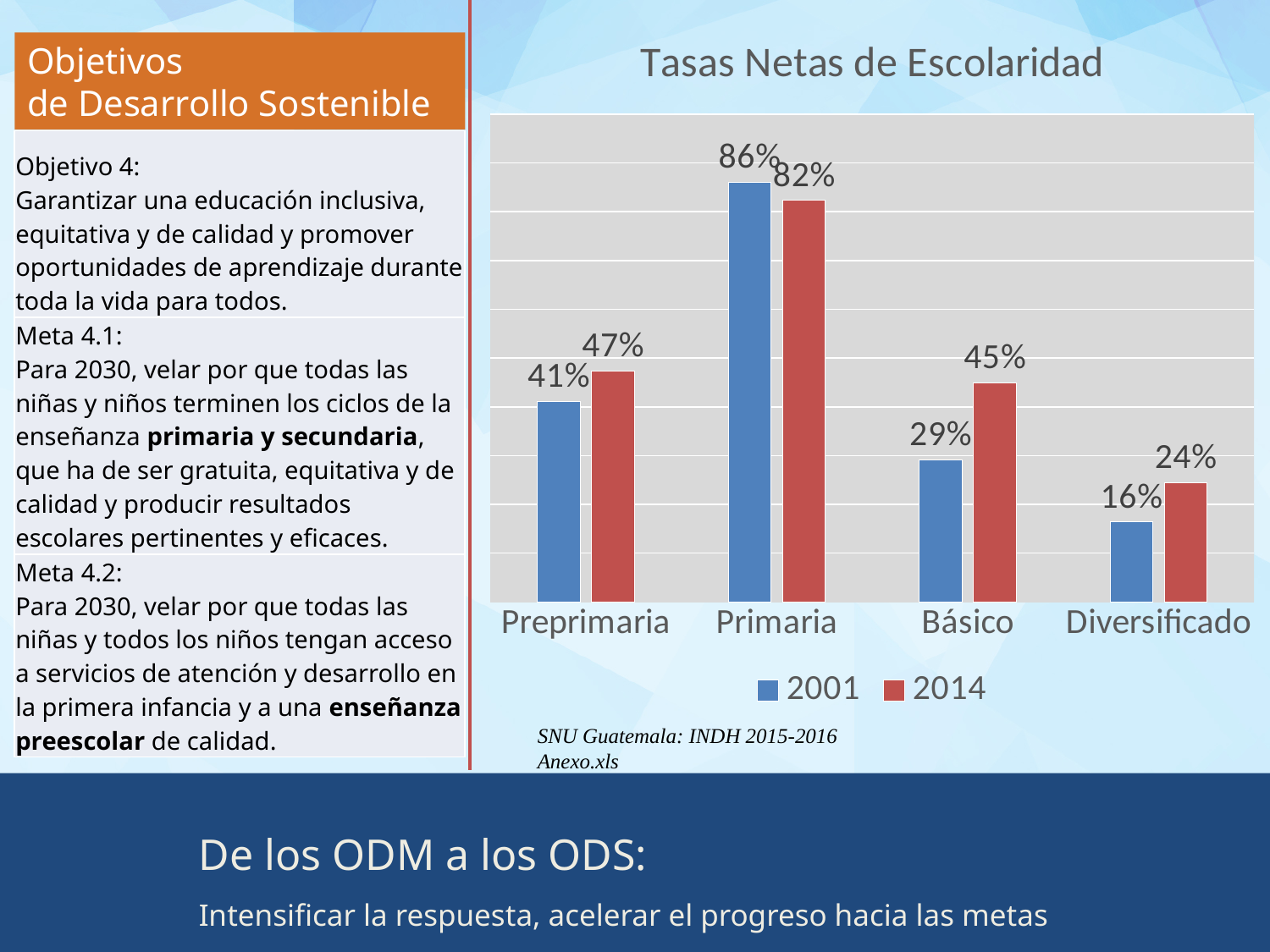
What is the value for Básico in 2001? 29% What is the title of the chart? Tasas Netas de Escolaridad What is the value for Primaria in 2001? 86% Which is larger for Primaria: the 2001 value or the 2014 value? 2001 Which series is shown in red in the legend? 2014 Which category has the lowest value in 2001? Diversificado How many series does the legend list? 2 What is the value for Diversificado in 2014? 24% How many categories are shown on the x axis? 4 Which category has the highest value in 2014? Primaria What is the difference between the 2014 and 2001 values for Básico? 16% What type of chart is shown on the slide? bar chart